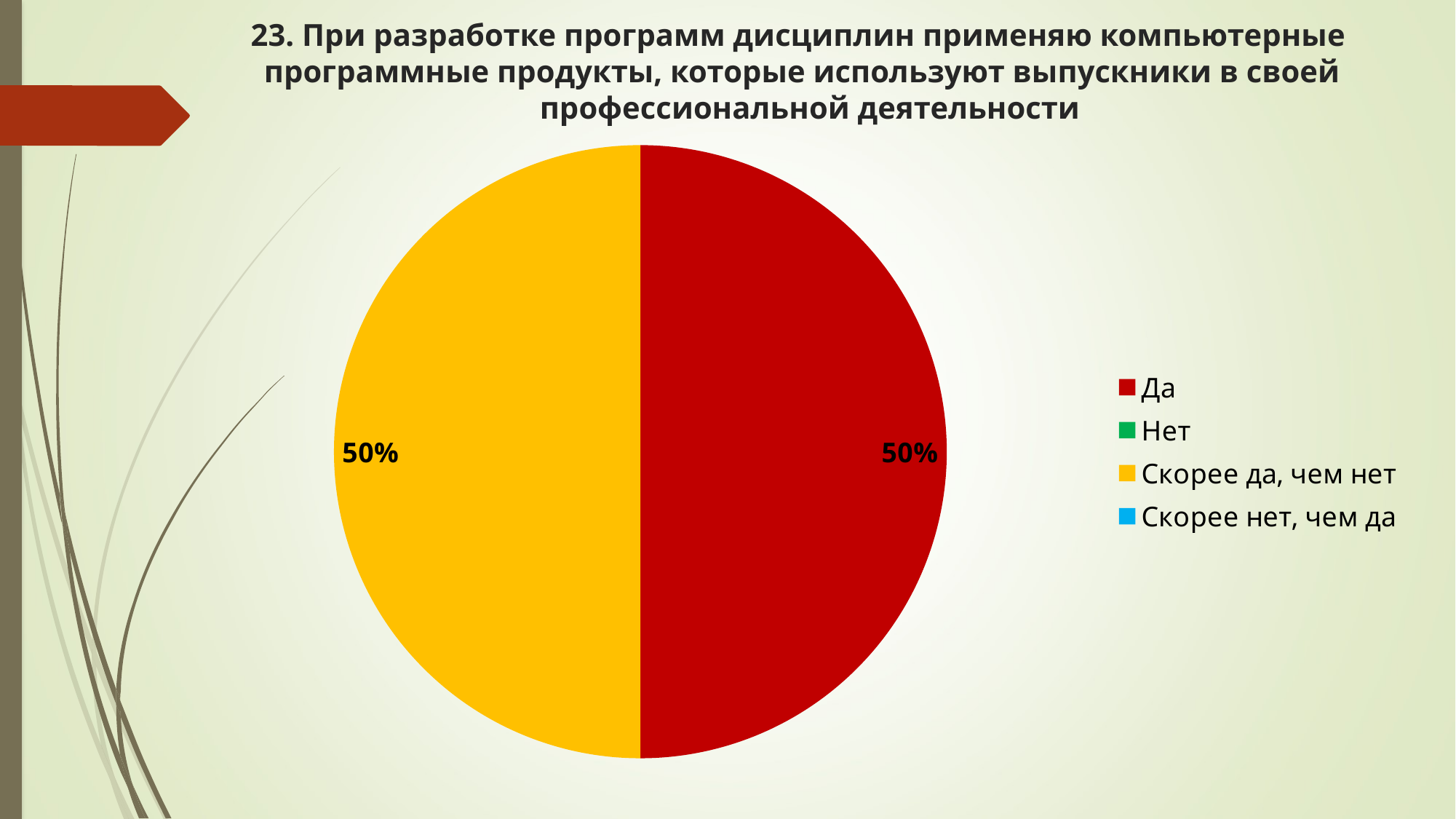
What share of the pie does the "Да" slice represent? 50% What share of the pie does the "Скорее да, чем нет" slice represent? 50% What kind of chart is shown on the slide? Pie chart Is the share for "Да" greater or less than 40%? greater What colour is the "Да" slice in the pie chart? Red What is the difference between the shares of "Да" and "Скорее да, чем нет"? 0% Which legend entry is shown in yellow? Скорее да, чем нет How many slices are visible in the pie chart? 2 What is the combined share of the "Да" and "Скорее да, чем нет" slices? 100% How many entries does the legend list? 4